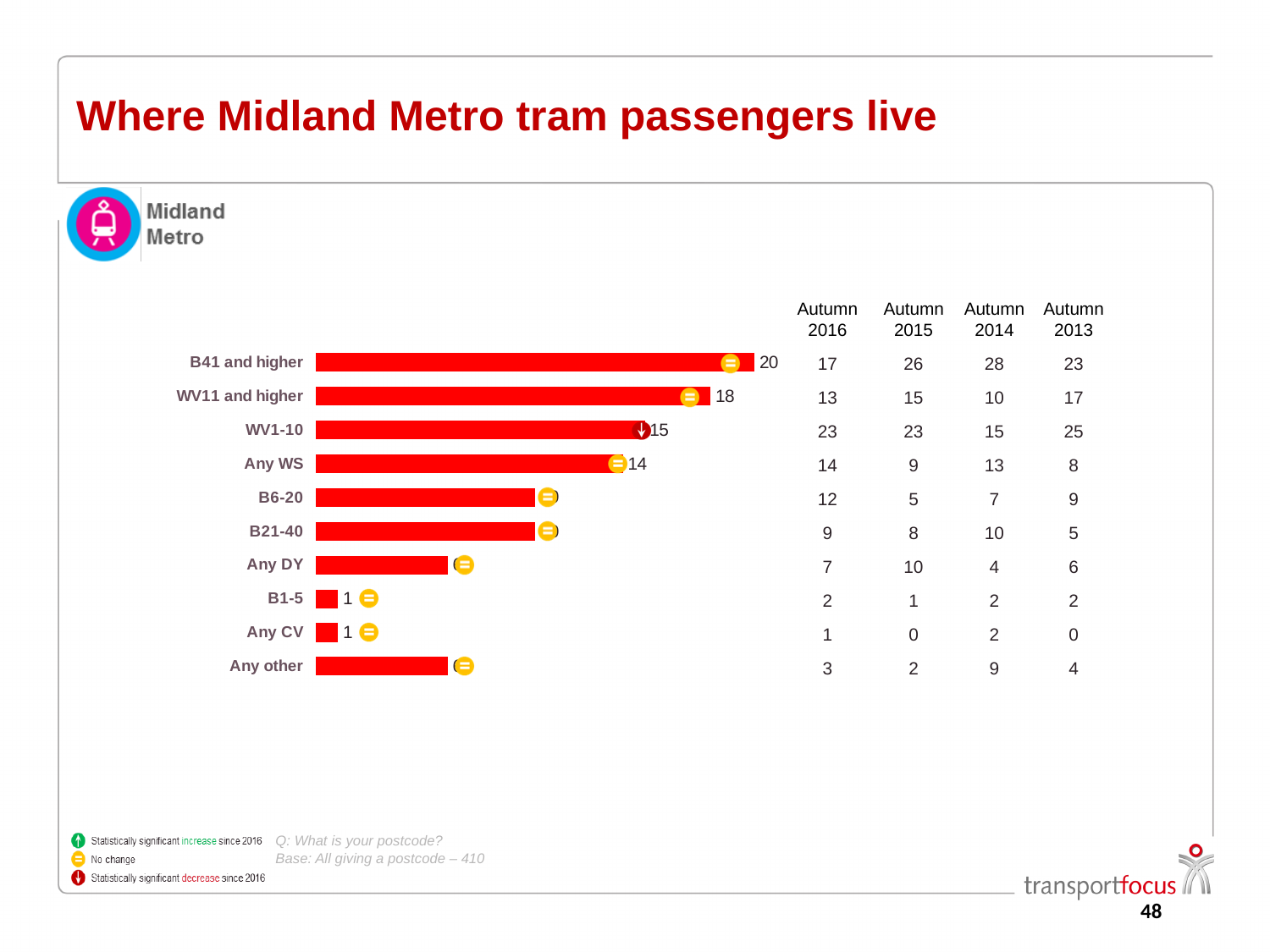
What is the value for B41 and higher? 20 What is the value for B1-5? 1 What is the difference between the values for WV1-10 and Any WS? 1 What is the value for WV1-10? 15 What is the title of the slide? Where Midland Metro tram passengers live How many categories are shown in the bar chart? 10 What is the value for WV11 and higher? 18 What is the difference between the values for B41 and higher and WV11 and higher? 2 What is the value for Any WS? 14 Which category has the highest value in the bar chart? B41 and higher What kind of chart is shown on the slide? Bar chart Which is larger, the value for WV11 and higher or the value for WV1-10? WV11 and higher